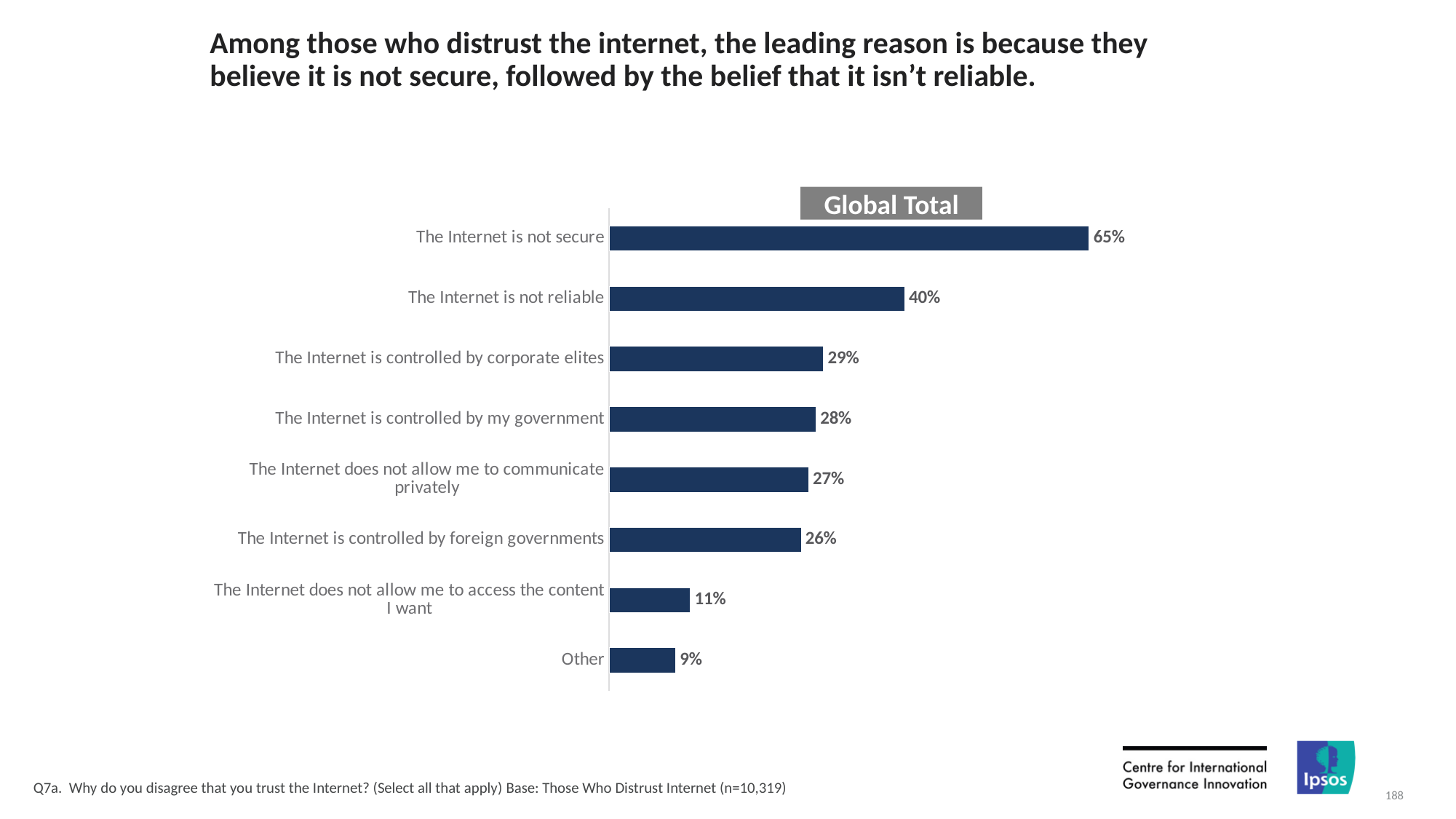
What percentage of respondents said "The Internet is not secure"? 65% Which is larger: "The Internet is controlled by corporate elites" or "The Internet is controlled by foreign governments"? The Internet is controlled by corporate elites Which category has the lowest value? Other What is the value for "The Internet is controlled by my government"? 28% What is the value for "The Internet does not allow me to access the content I want"? 11% What kind of chart is shown on the slide? Bar chart What is the value for "The Internet is not reliable"? 40% What is the difference between "The Internet does not allow me to communicate privately" and "Other"? 18 percentage points What is the difference between "The Internet is not secure" and "The Internet is not reliable"? 25 percentage points Which reason has the highest value? The Internet is not secure What is the label shown in the grey box above the chart? Global Total How many categories are shown in the chart? 8